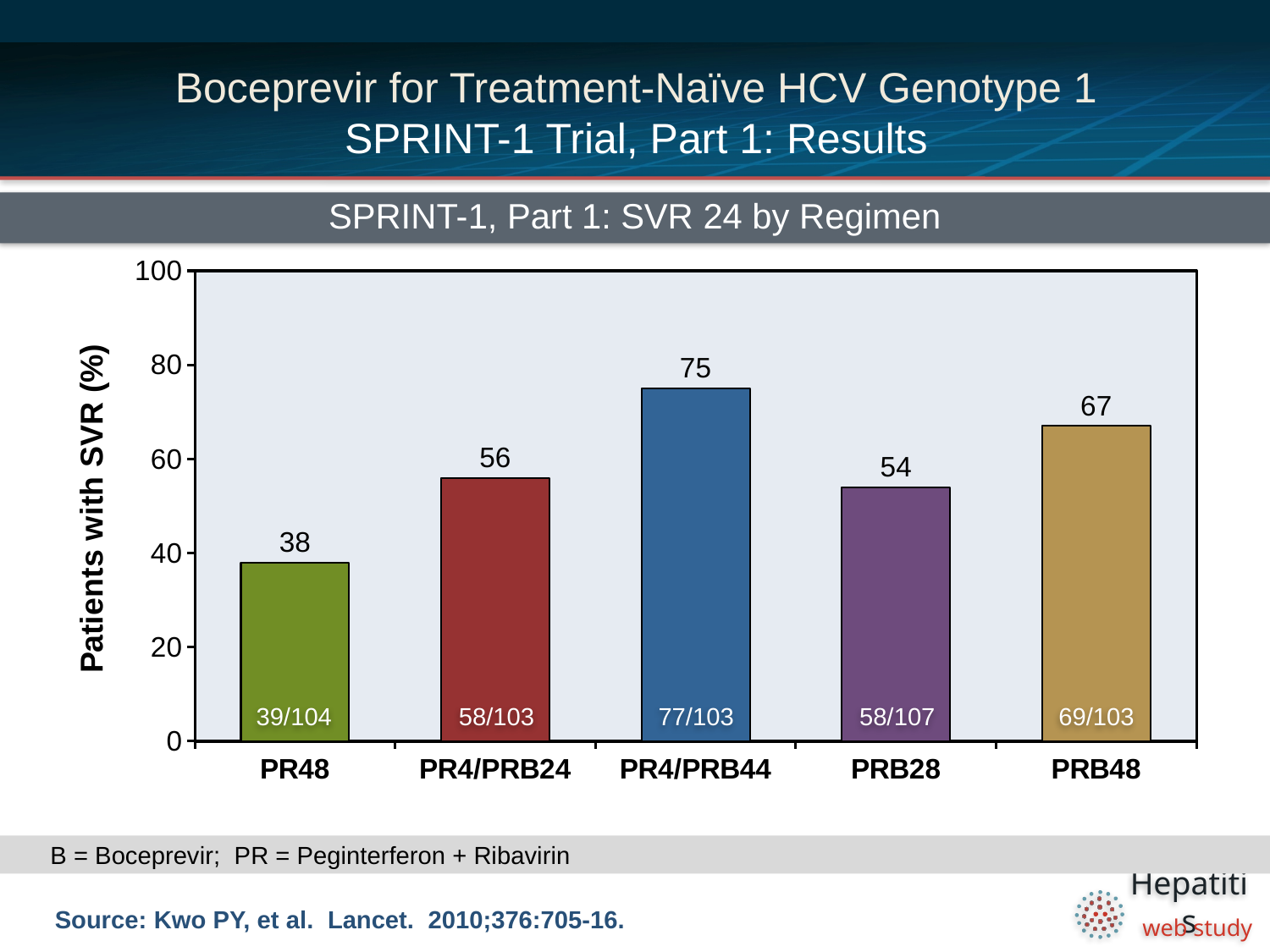
What is the difference in SVR percentage between PR4/PRB44 and PR48? 37 What is the percentage of patients with SVR for the PRB28 regimen? 54 What is the percentage of patients with SVR for the PR48 regimen? 38 What is the label of the y-axis? Patients with SVR (%) What fraction of patients is shown inside the PRB48 bar? 69/103 Which regimen has the lowest percentage of patients with SVR? PR48 Which regimen has the highest percentage of patients with SVR? PR4/PRB44 What kind of chart is shown on the slide? Bar chart What is the title of the chart? SPRINT-1, Part 1: SVR 24 by Regimen How many regimens are shown on the chart? 5 Which regimen has a higher SVR percentage, PR4/PRB24 or PRB48? PRB48 What is the percentage of patients with SVR for the PR4/PRB44 regimen? 75